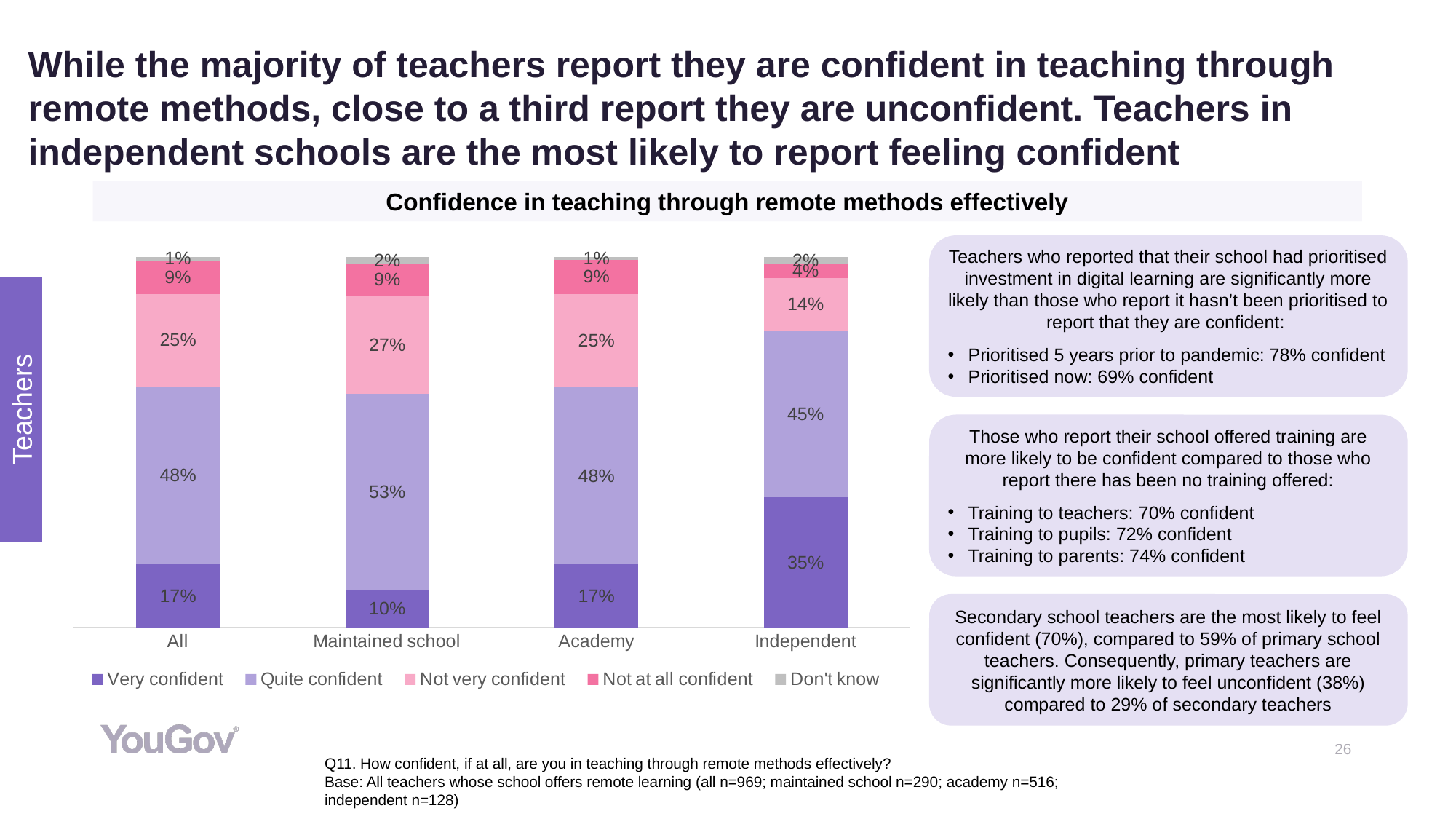
What is the difference between the Very confident values for Independent and Maintained school? 25 percentage points How many series does the legend list? 5 What is the Not very confident value for Academy? 25% What is the combined share of Very confident and Quite confident for Independent? 80% Which school type has the lowest Very confident percentage? Maintained school What percentage of teachers in independent schools are very confident in teaching through remote methods effectively? 35% What kind of chart is shown on the slide? Stacked bar chart Which school type has the highest Very confident percentage? Independent What is the Quite confident value for Maintained school? 53% What is the title of the chart? Confidence in teaching through remote methods effectively Which is larger, the Not very confident value for Maintained school or for Independent? Maintained school How many school categories are shown on the x axis? 4